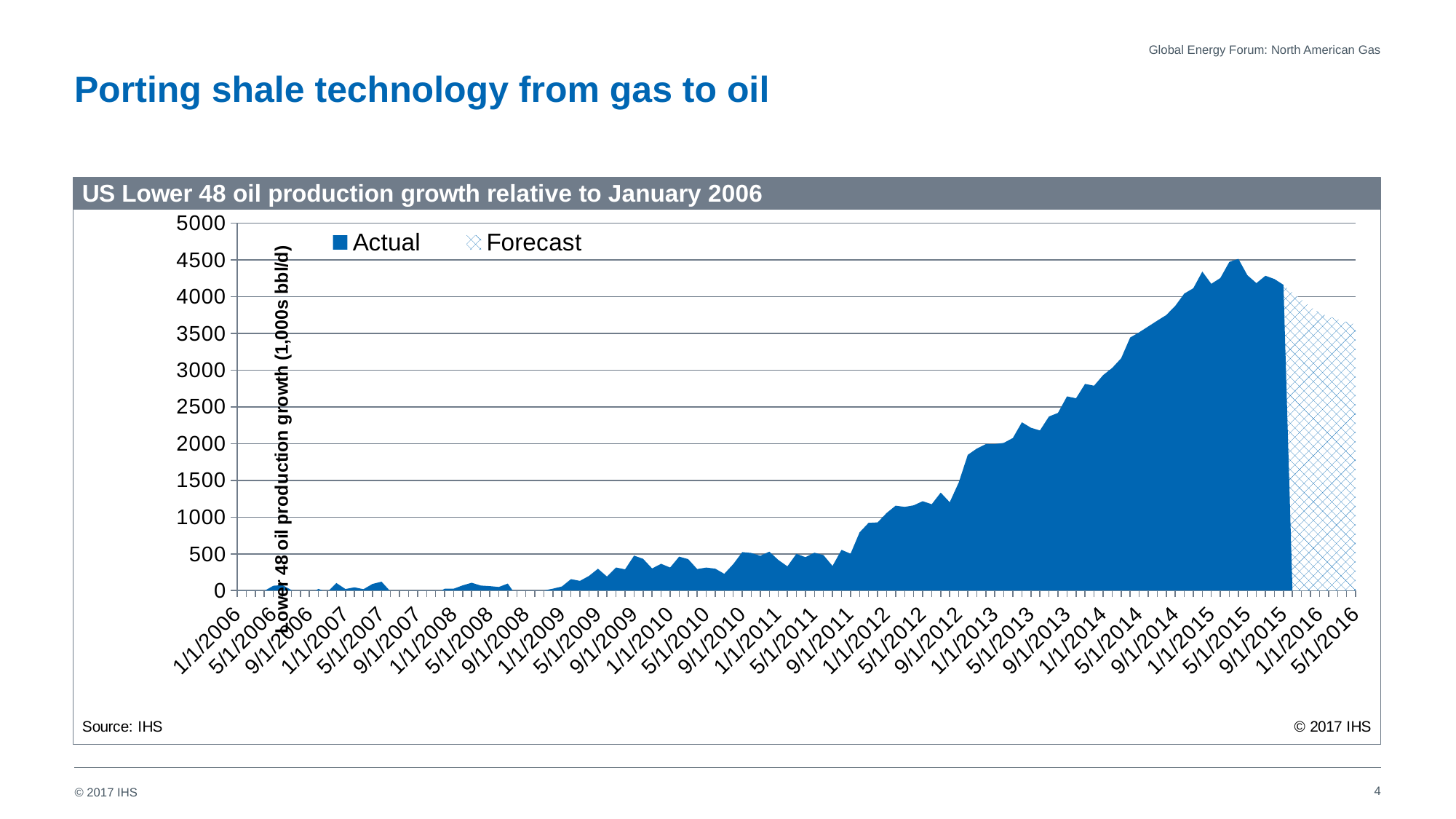
What is the title of the chart? US Lower 48 oil production growth relative to January 2006 Overall, do the values rise or fall from 1/1/2006 to 9/1/2015? Rise Is the value for 1/1/2010 greater or less than 500? less What kind of chart is shown on the slide? Area chart Is the forecast value for 5/1/2016 greater or less than 3000? greater What are the two series named in the legend? Actual and Forecast Which is larger, the actual value for 1/1/2015 or the forecast value for 5/1/2016? 1/1/2015 Which is larger, the value for 1/1/2014 or the value for 1/1/2012? 1/1/2014 Is the value for 1/1/2014 greater or less than 2500? greater How many series does the legend list? 2